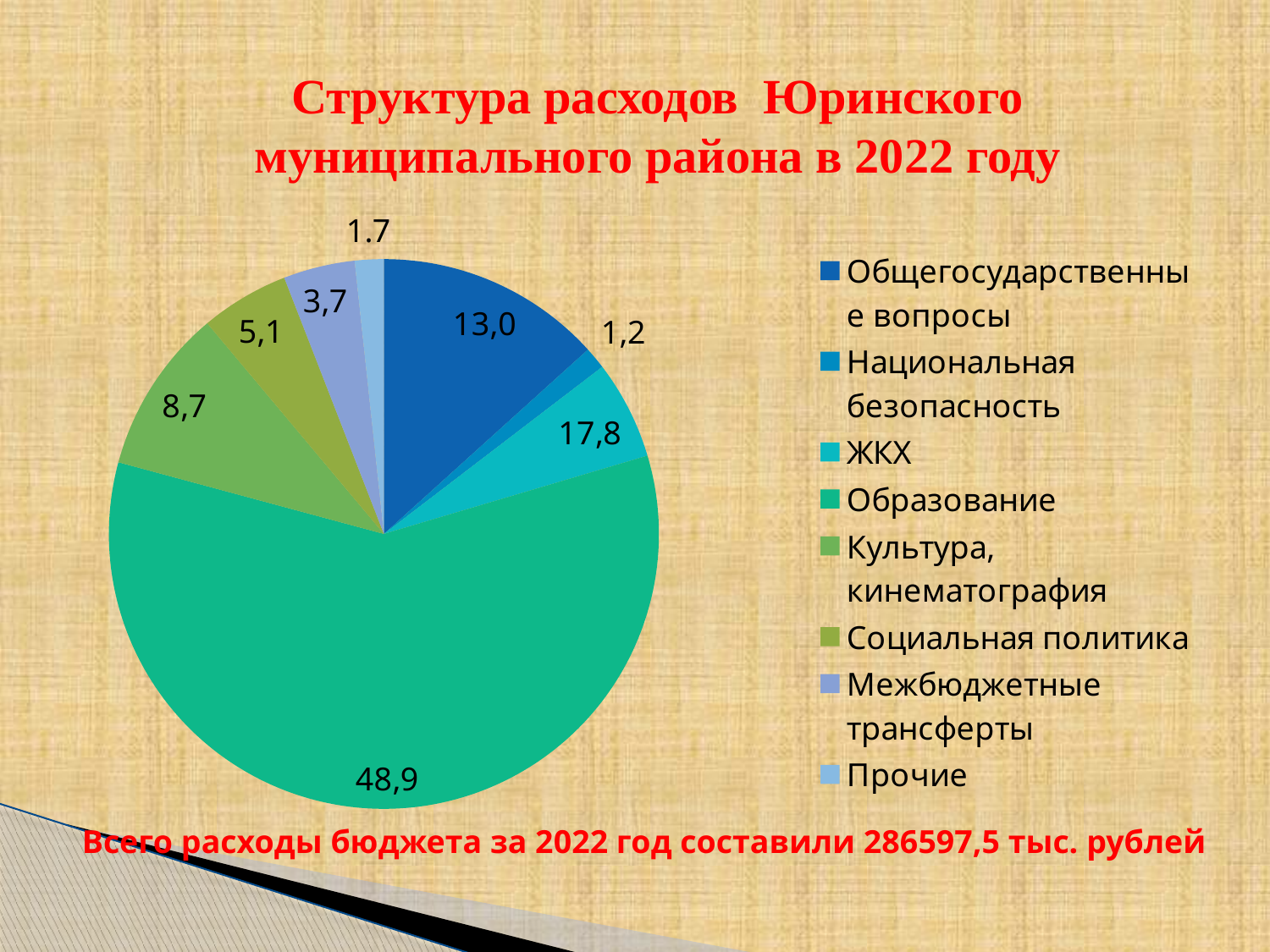
What is the value shown for Общегосударственные вопросы? 13,0 Which is larger, the value for Социальная политика or the value for Культура, кинематография? Культура, кинематография What is the value shown for Межбюджетные трансферты? 3,7 How many categories does the legend list? 8 What kind of chart is shown on the slide? Pie chart Which category has the smallest slice of the pie? Национальная безопасность What is the value shown for Культура, кинематография? 8,7 What is the difference between the values for Образование and ЖКХ? 31,1 What is the value shown for ЖКХ? 17,8 What is the value shown for Образование? 48,9 What is the title of the chart? Структура расходов Юринского муниципального района в 2022 году Which category has the largest slice of the pie? Образование